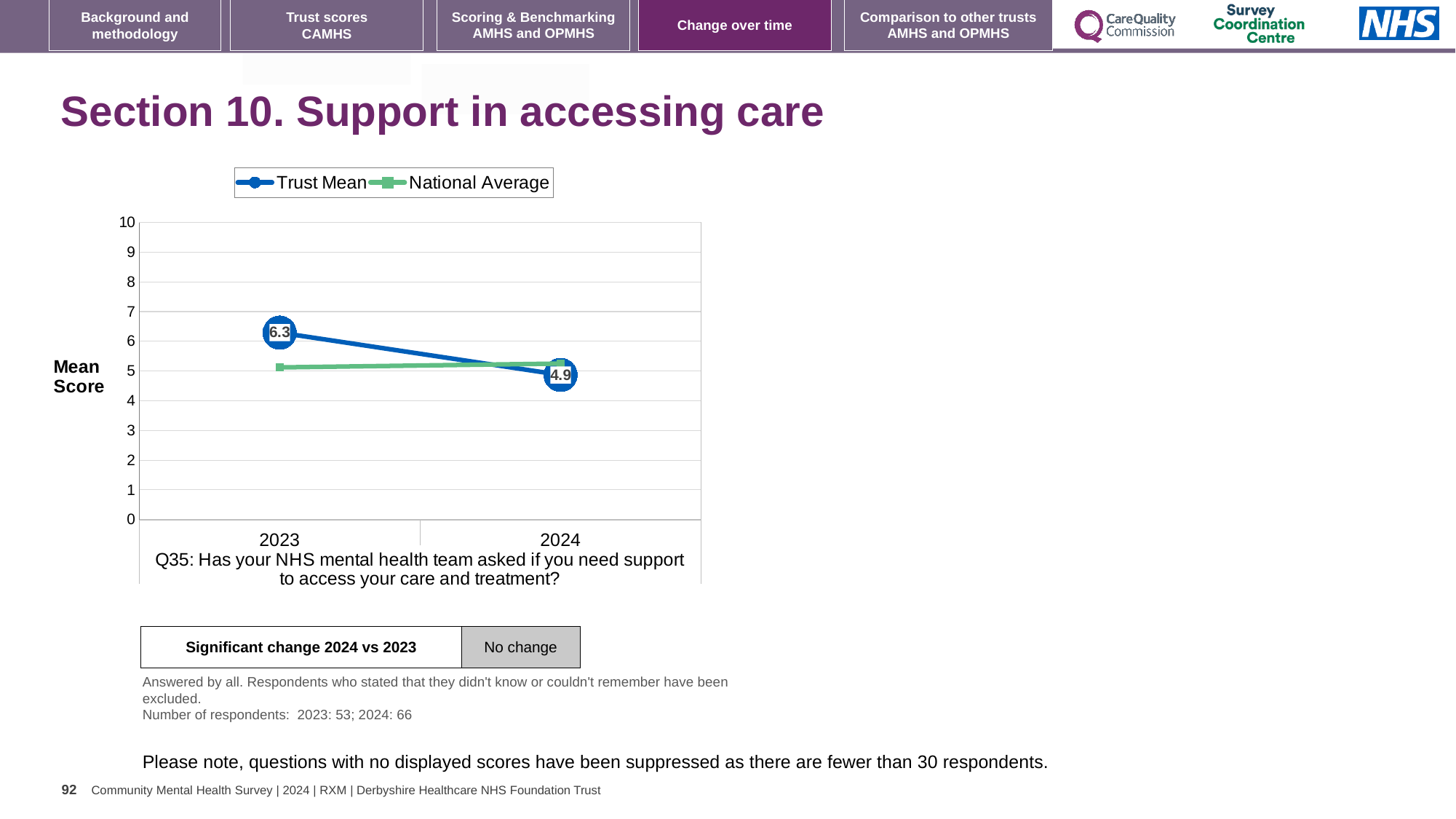
What is the Trust Mean score for 2023? 6.3 In which year was the Trust Mean score lower? 2024 In 2023, which is higher: the Trust Mean or the National Average? Trust Mean What is the Trust Mean score for 2024? 4.9 Does the Trust Mean rise or fall from 2023 to 2024? fall How many series does the legend list? 2 By how much did the Trust Mean score change from 2023 to 2024? 1.4 Is the National Average value for 2024 greater or less than 6? less What kind of chart is shown on the slide? line chart In which year was the Trust Mean score higher? 2023 What is the label on the y axis of the chart? Mean Score How many years are plotted on the x axis? 2